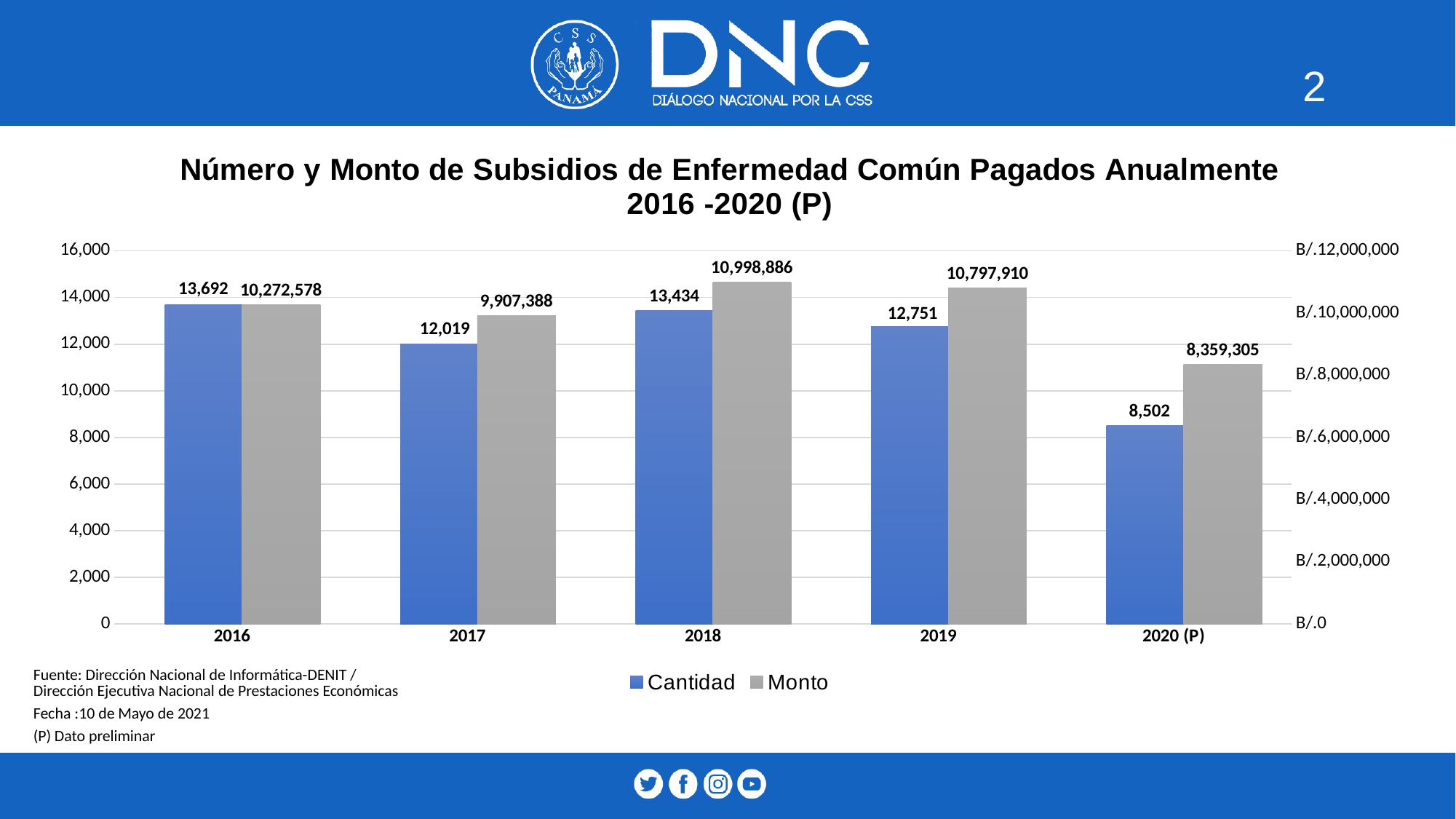
Which year has the lowest Cantidad value? 2020 (P) How many series does the legend list? 2 What is the difference between the Cantidad values for 2016 and 2017? 1,673 Which is larger, the Monto value for 2019 or the Monto value for 2017? 2019 How many years are shown on the x axis? 5 What kind of chart is shown on the slide? Bar chart What is the Cantidad value for 2016? 13,692 Which colour represents the Monto series in the legend? Grey Does the Cantidad value rise or fall from 2019 to 2020 (P)? Fall Which year has the highest Monto value? 2018 What is the Monto value for 2018? 10,998,886 What is the Cantidad value for 2020 (P)? 8,502